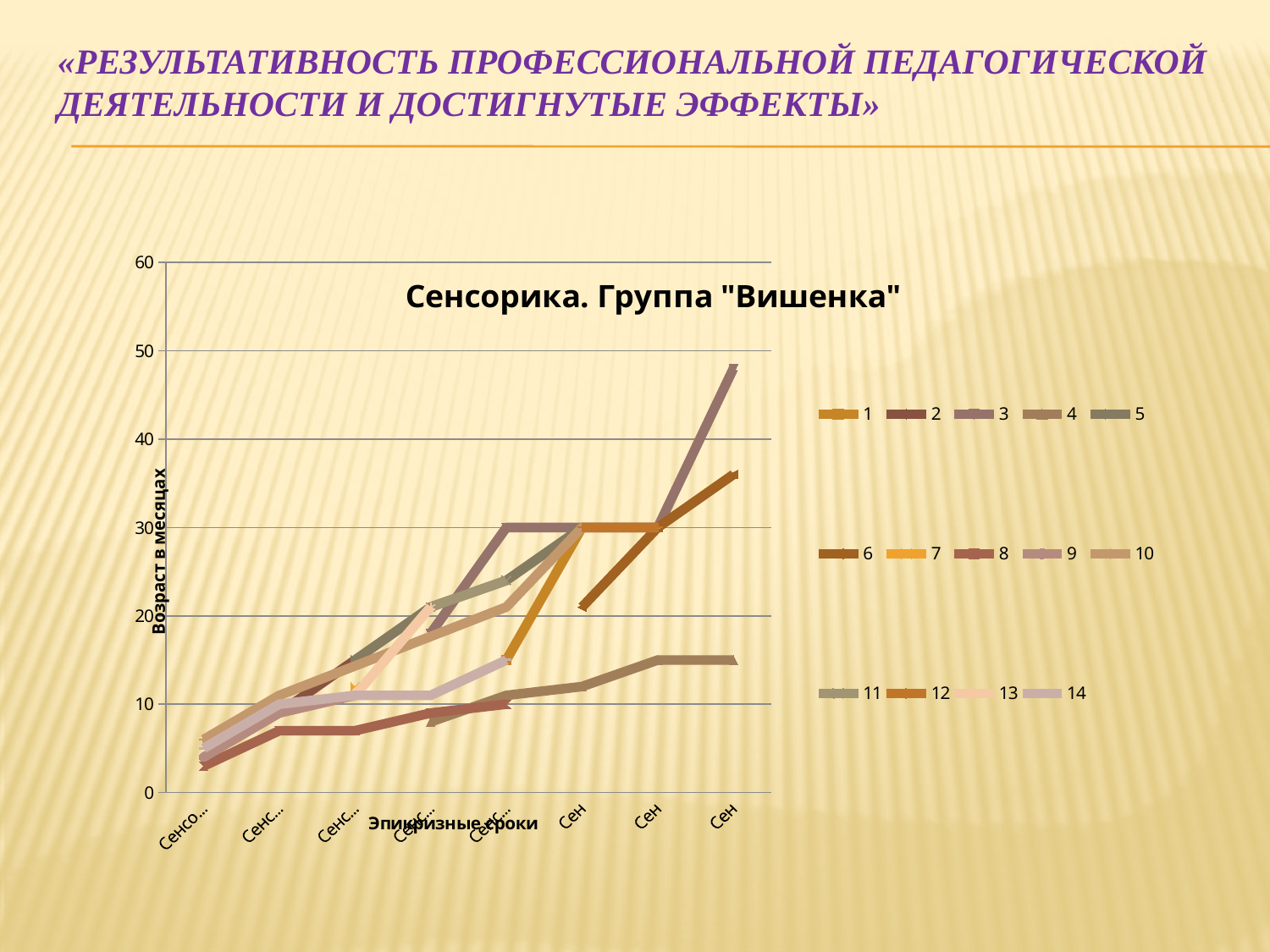
Do the plotted values generally rise or fall from left to right along the x axis? rise How many series does the chart's legend list? 14 What is the title of the chart? Сенсорика. Группа "Вишенка" Is the highest value plotted on the chart greater or less than 50? less What is the label of the vertical axis? Возраст в месяцах What is the maximum value shown on the vertical axis? 60 Are the values at the first x-axis point greater or less than 10? less Is the highest value plotted on the chart greater or less than 40? greater What kind of chart is shown on the slide? line chart How many points are there along the x axis of the chart? 8